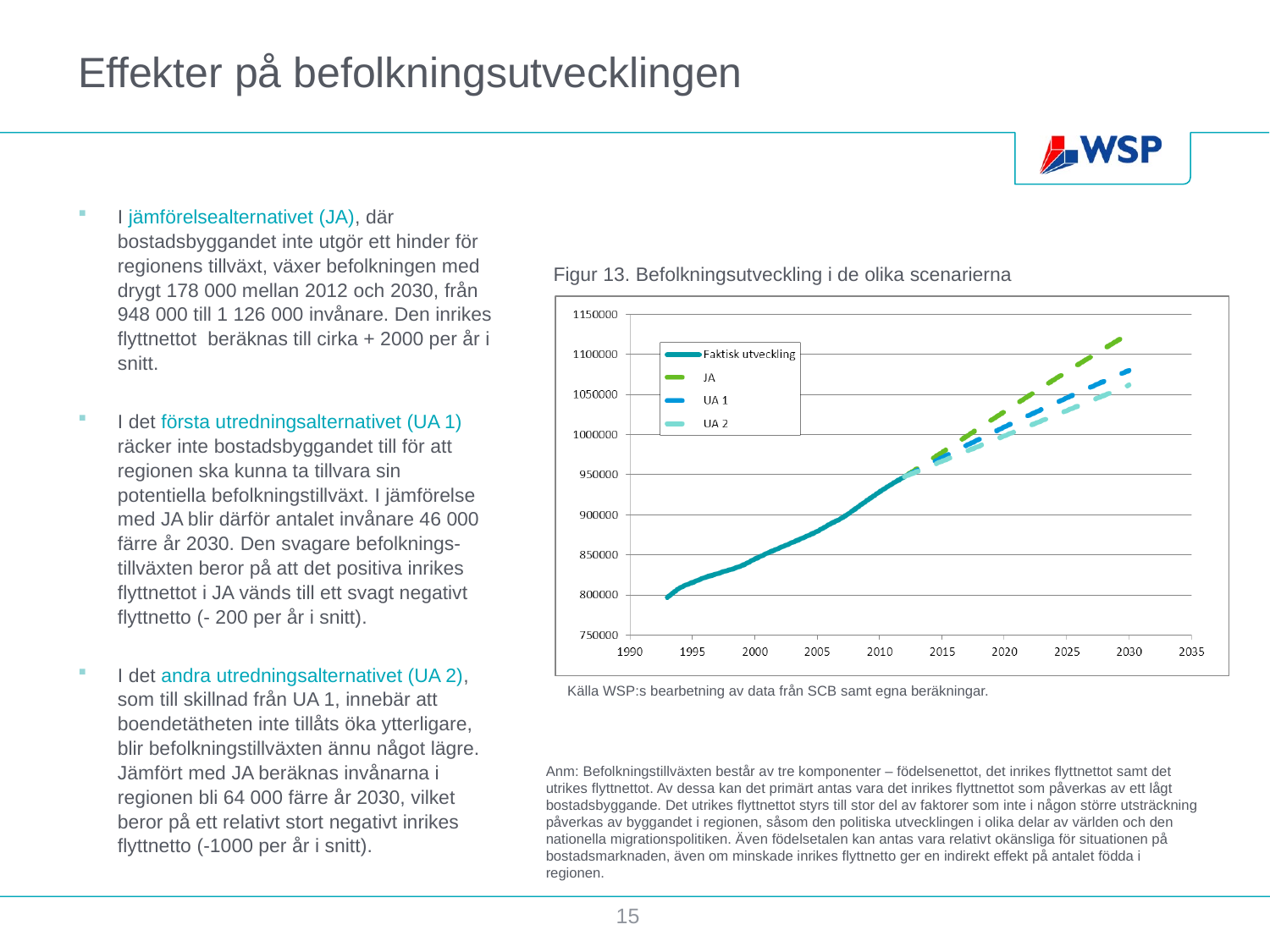
What is the title of the chart on the slide? Figur 13. Befolkningsutveckling i de olika scenarierna Which scenario line reaches the highest value by 2030? JA Which scenario line is lowest by 2030? UA 2 What kind of chart is shown in Figur 13? Line chart In 2030, which is larger, the JA line or the UA 2 line? JA Does the Faktisk utveckling line rise or fall from 1990 to 2012? Rises Is the value of the Faktisk utveckling line in 2005 greater or less than 900000? less Is the value of the Faktisk utveckling line in 2010 greater or less than 900000? greater Is the value of the UA 1 line in 2030 greater or less than 1100000? less What are the series names listed in the chart legend? Faktisk utveckling, JA, UA 1, UA 2 How many series does the legend of the chart list? 4